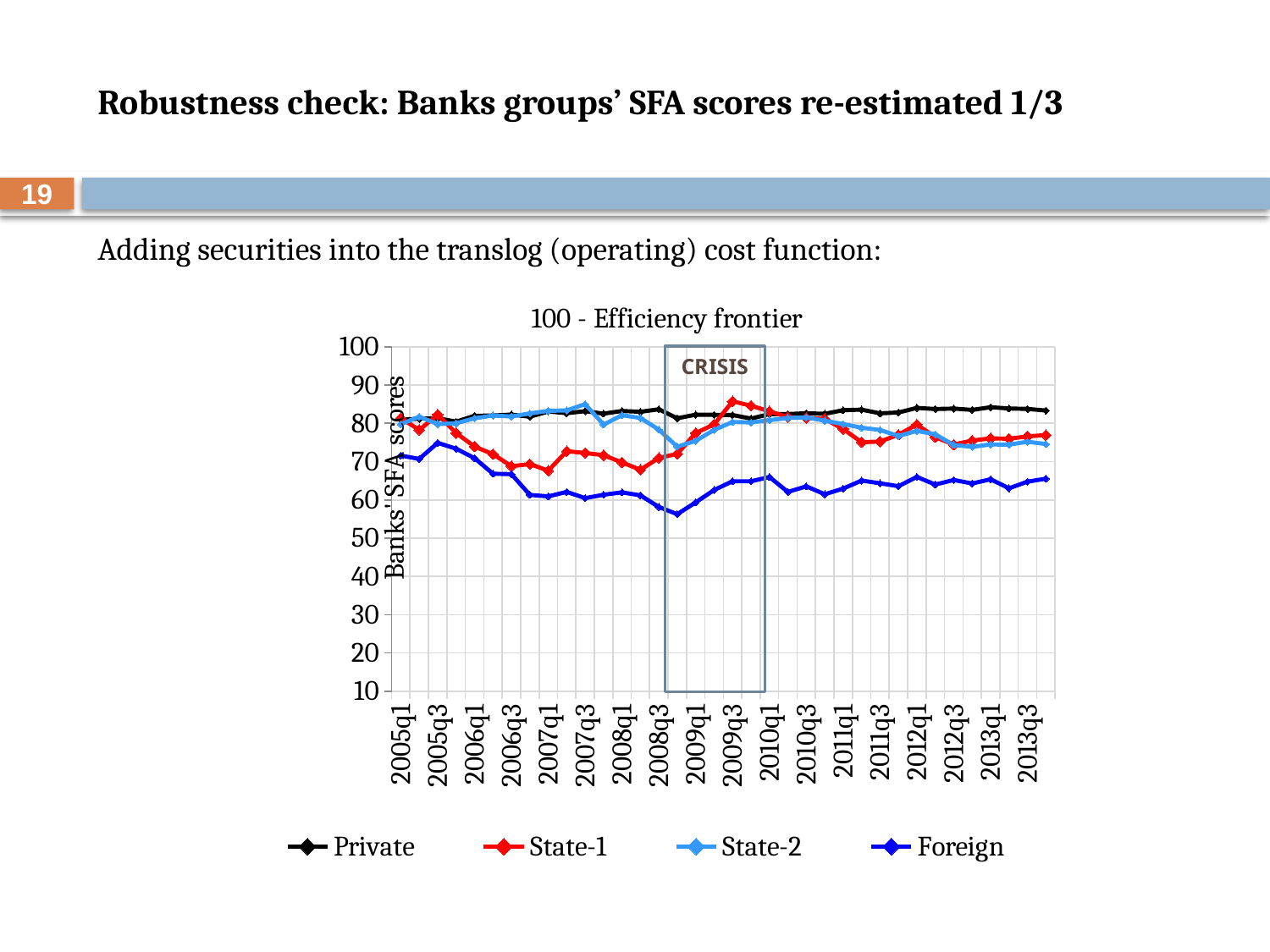
Which series has the highest value at 2013q3? Private Which series has the lowest values across the whole period? Foreign Is the value for Foreign at 2005q3 greater or less than 70? greater Is the value for Private at 2013q3 greater or less than 80? greater Does the Foreign series rise or fall from 2005q3 to 2009q1? fall What kind of chart is shown on the slide? line chart At 2009q1, which is larger: the value for Private or the value for Foreign? Private What is the title of the chart? 100 - Efficiency frontier Is the value for State-1 at 2007q1 greater or less than 70? less What label is written inside the boxed region on the chart? CRISIS How many series does the legend list? 4